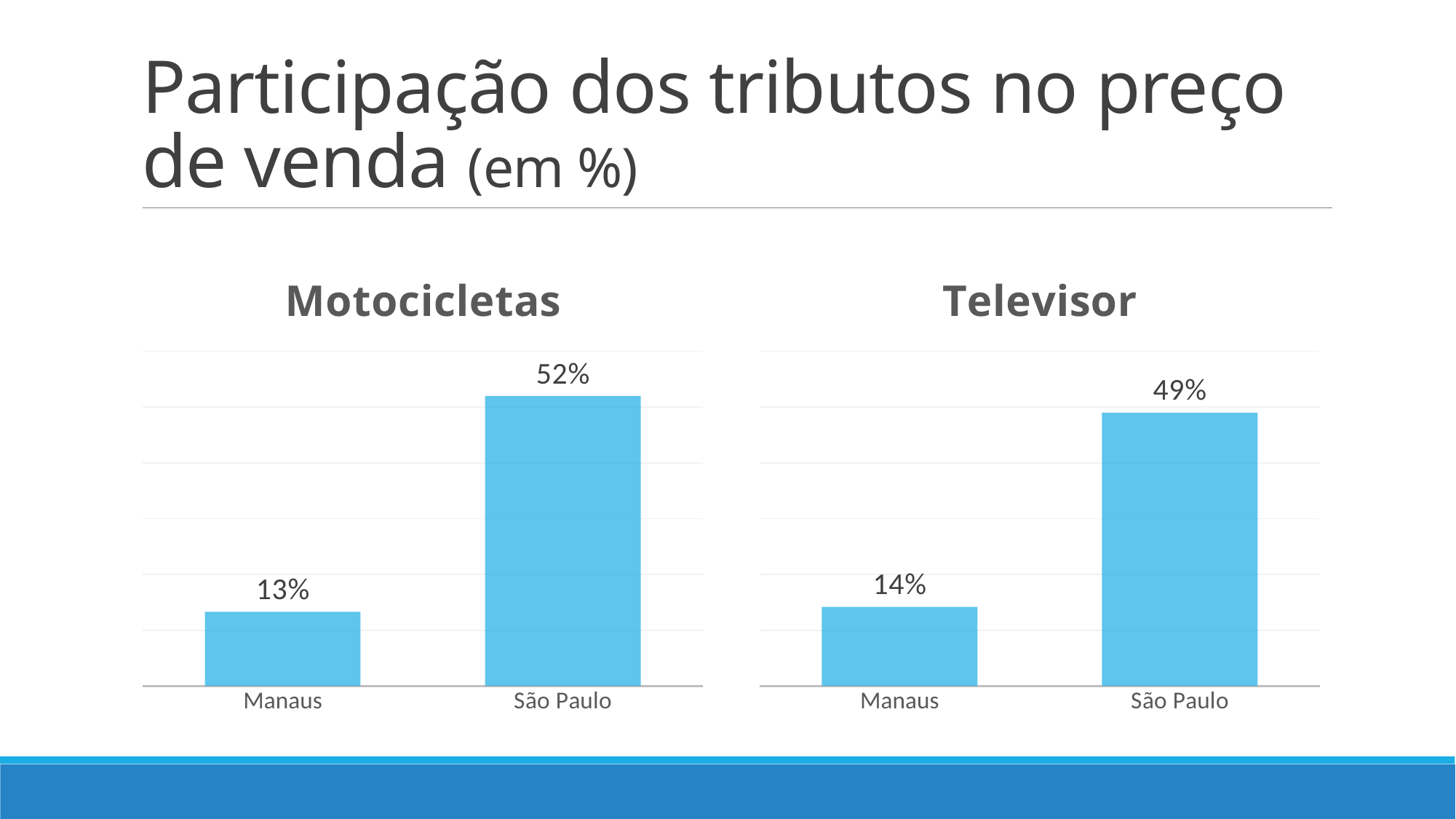
In the Motocicletas chart, what is the difference between the São Paulo and Manaus values? 39% What kind of chart is the Motocicletas chart? Bar chart In the Televisor chart, what is the difference between the São Paulo and Manaus values? 35% In the Televisor chart, what is the value for Manaus? 14% In the Motocicletas chart, what is the value for São Paulo? 52% What is the title of the chart on the right side of the slide? Televisor In the Motocicletas chart, what is the value for Manaus? 13% In the Televisor chart, which category has the lowest value? Manaus Which is larger: the São Paulo value in the Motocicletas chart or the São Paulo value in the Televisor chart? Motocicletas How many categories does the Televisor chart show? 2 In the Motocicletas chart, which category has the highest value? São Paulo In the Televisor chart, what is the value for São Paulo? 49%